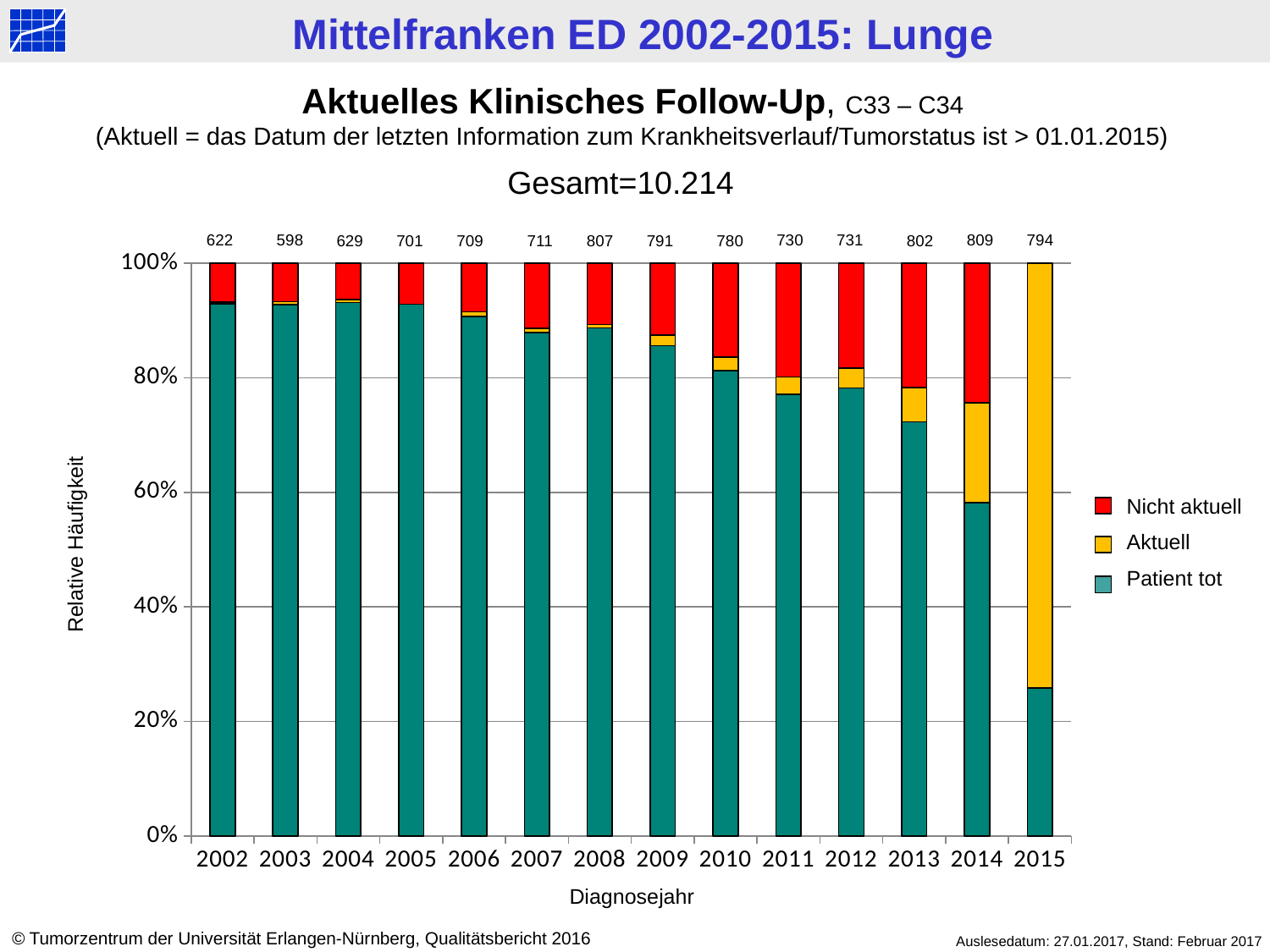
Is the 'Patient tot' share for 2002 greater or less than 80%? greater What is the difference between the case counts printed above the bars for 2014 and 2002? 187 How many diagnosis years (categories) are shown on the x axis? 14 Which series is shown in red in the legend? Nicht aktuell What is the case count printed above the bar for 2008? 807 Which diagnosis year has the lowest case count printed above its bar? 2003 What kind of chart is shown on the slide? stacked bar chart How many series does the legend list? 3 Which diagnosis year has the highest case count printed above its bar? 2014 Is the 'Patient tot' share for 2015 greater or less than 40%? less What is the case count printed above the bar for 2003? 598 What is the case count printed above the bar for 2015? 794